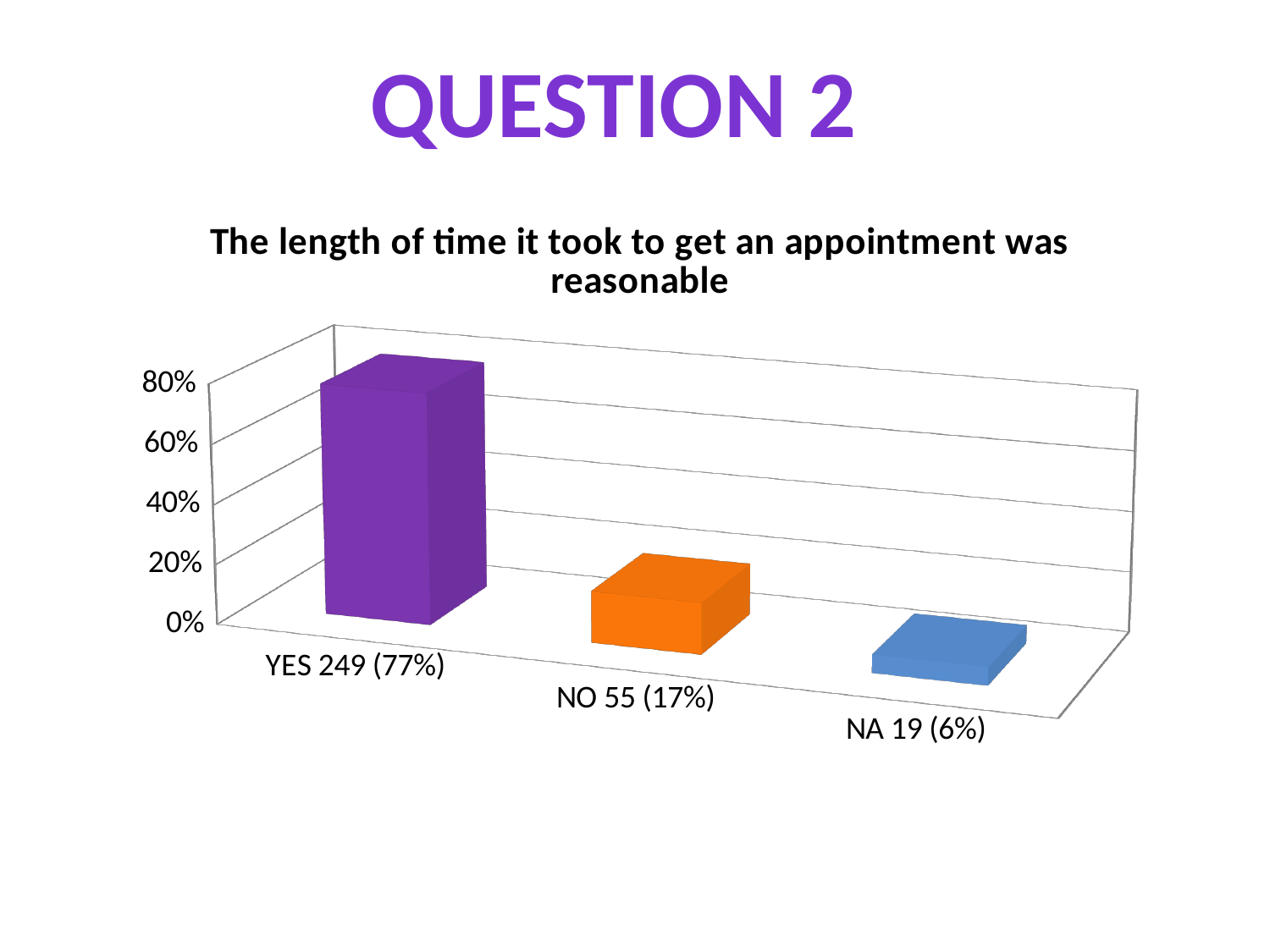
How many categories are plotted in the chart? 3 What percentage of responses were NA? 6% What kind of chart is shown on the slide? bar chart How many respondents answered NO? 55 What is the difference in percentage points between YES and NO? 60 Which category has the highest value? YES What is the title of the chart? The length of time it took to get an appointment was reasonable Which is larger, the NO bar or the NA bar? NO Is the value for YES greater or less than 60%? greater Which category has the lowest value? NA What percentage of responses were YES? 77% Do the values rise or fall from left to right across the categories? fall